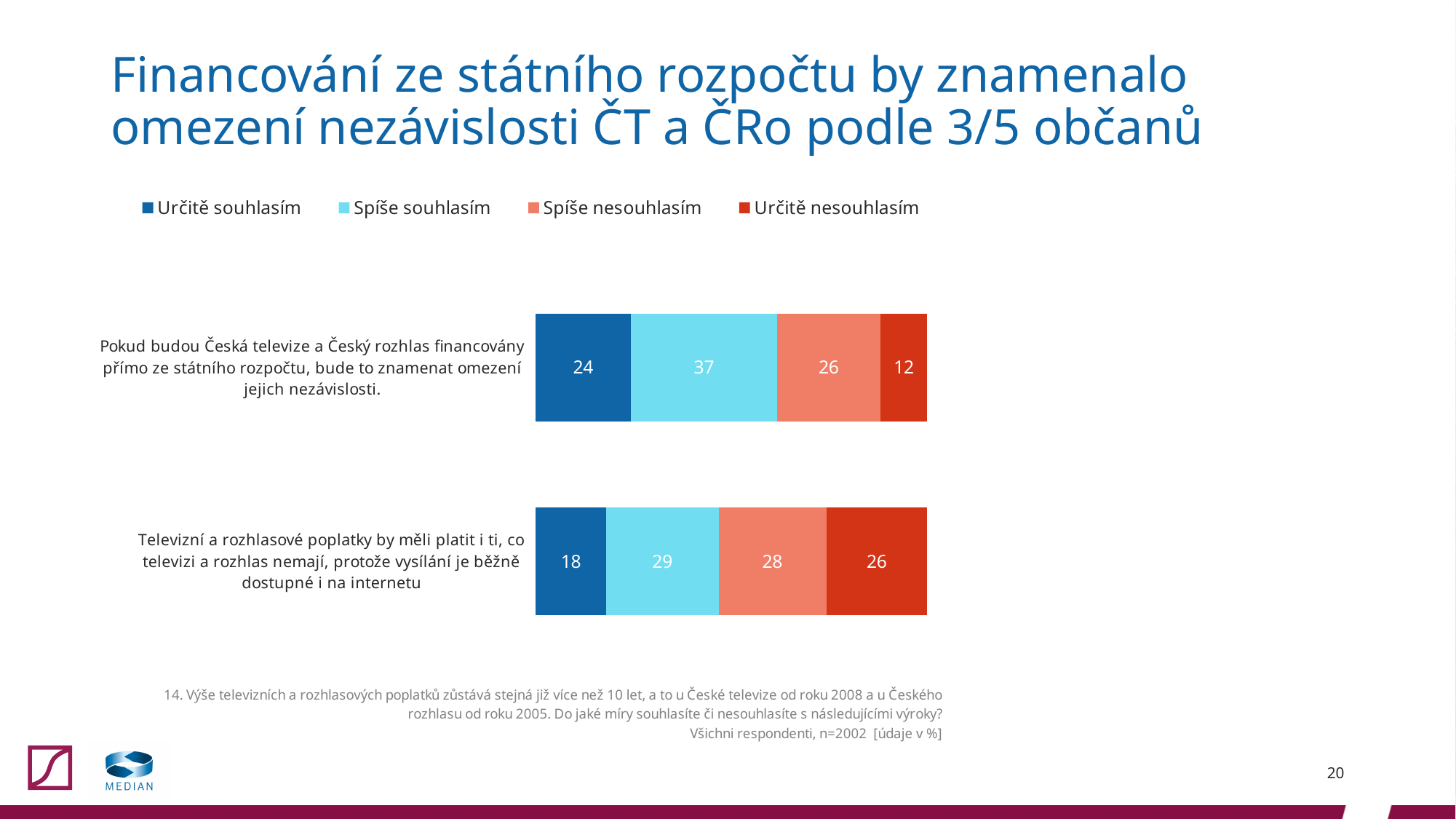
What is the combined value of "Určitě souhlasím" and "Spíše souhlasím" for the statement about financing from the state budget limiting independence? 61 What is the value for "Určitě nesouhlasím" for the statement about financing from the state budget limiting independence? 12 Which is larger: "Určitě souhlasím" for the state budget statement or "Určitě souhlasím" for the fees statement? State budget statement (24) What is the value for "Určitě souhlasím" for the statement about financing from the state budget limiting independence? 24 Which response category has the highest value for the statement about financing from the state budget limiting independence? Spíše souhlasím What is the difference between "Určitě nesouhlasím" for the fees statement and "Určitě nesouhlasím" for the state budget statement? 14 How many statements (bars) are shown in the chart? 2 What kind of chart is shown on the slide? Stacked bar chart How many series does the legend list? 4 What is the value for "Spíše souhlasím" for the statement that TV and radio fees should also be paid by those who do not own a TV or radio? 29 What is the value for "Spíše nesouhlasím" for the statement that fees should also be paid by those without a TV or radio? 28 Which response category has the lowest value for the statement that fees should also be paid by those without a TV or radio? Určitě souhlasím